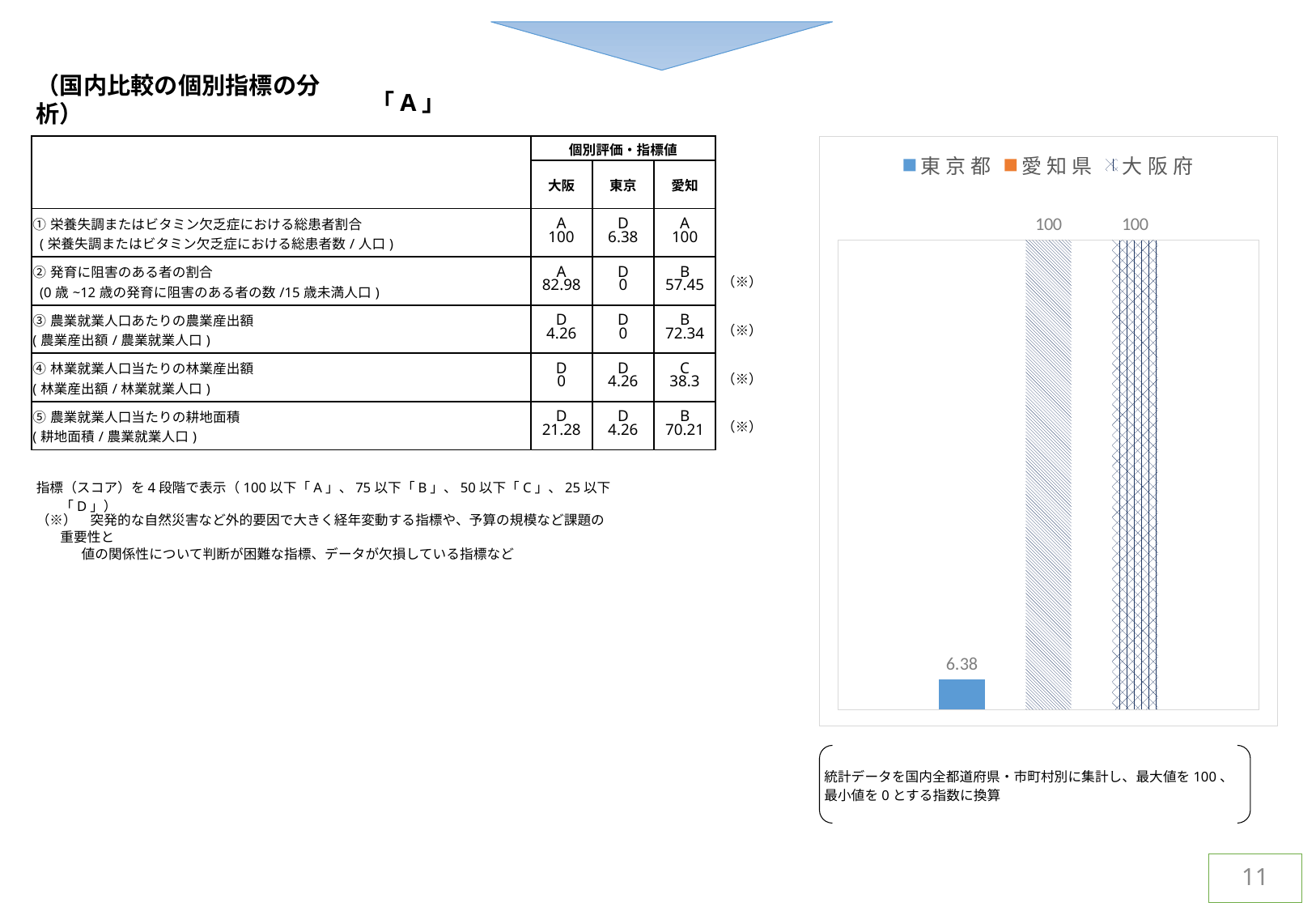
Are the values for 愛知県 and 大阪府 in the bar chart equal? yes What is the difference between the values for 愛知県 and 東京都 in the bar chart? 93.62 What is the value shown for 愛知県 in the bar chart? 100 How many bars are plotted in the chart? 3 What is the value shown for 東京都 in the bar chart? 6.38 Which is larger in the bar chart, the value for 東京都 or the value for 大阪府? 大阪府 What kind of chart is shown on the right of the slide? bar chart What is the first entry listed in the legend of the bar chart? 東京都 What is the value shown for 大阪府 in the bar chart? 100 How many series does the legend of the bar chart list? 3 Which series has the lowest value in the bar chart? 東京都 Which legend entry in the bar chart is shown in solid blue? 東京都